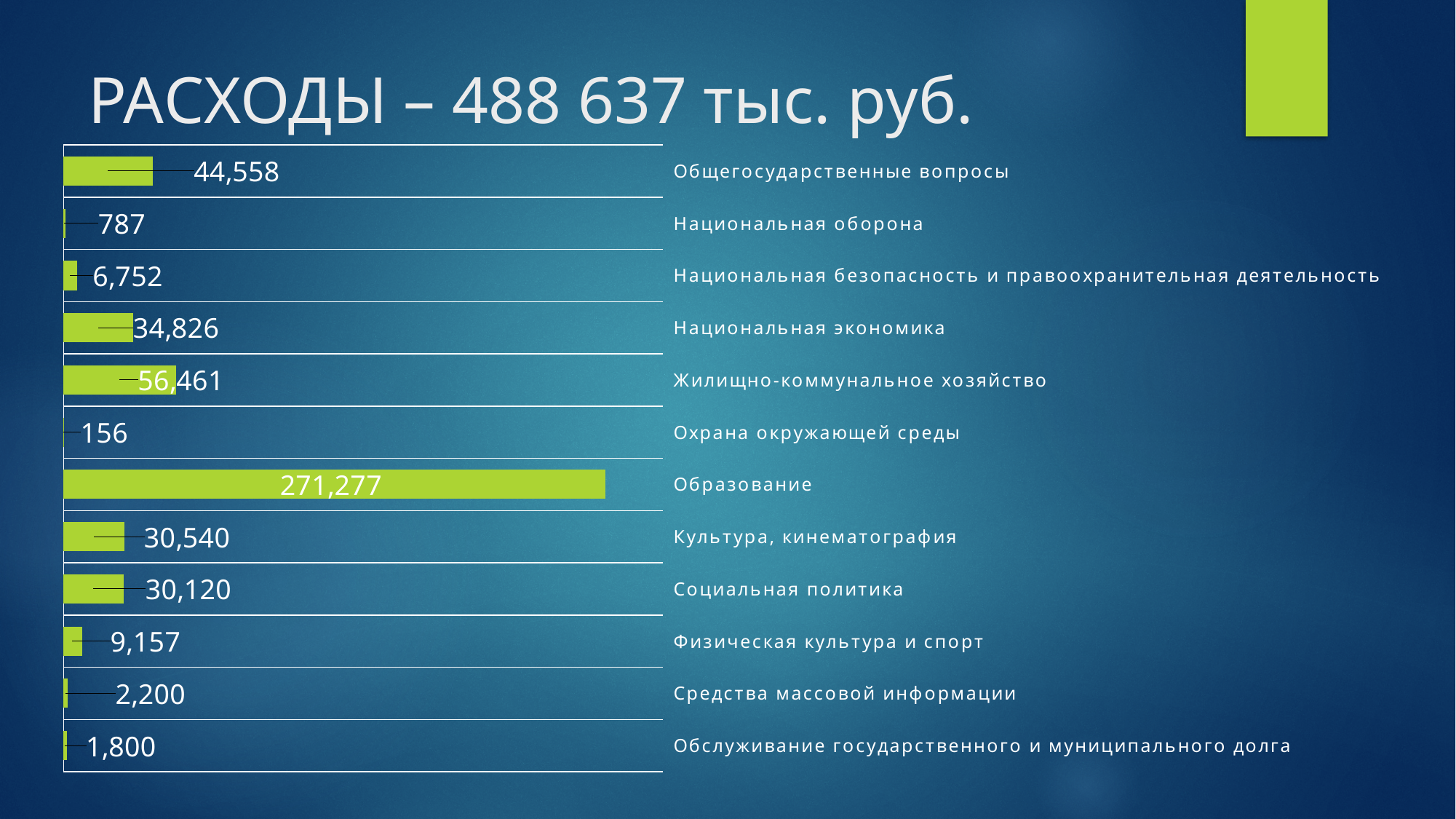
What is the title of the slide? РАСХОДЫ – 488 637 тыс. руб. What is the value for Охрана окружающей среды? 156 What is the difference between the values for Жилищно-коммунальное хозяйство and Общегосударственные вопросы? 11,903 What is the value for Национальная экономика? 34,826 Which is larger, the value for Культура, кинематография or the value for Социальная политика? Культура, кинематография What is the value for Средства массовой информации? 2,200 Which category has the lowest value? Охрана окружающей среды Which category has the highest value? Образование What is the difference between the values for Физическая культура и спорт and Национальная безопасность и правоохранительная деятельность? 2,405 What is the value for Образование? 271,277 How many categories are shown in the chart? 12 What kind of chart is shown on the slide? Bar chart